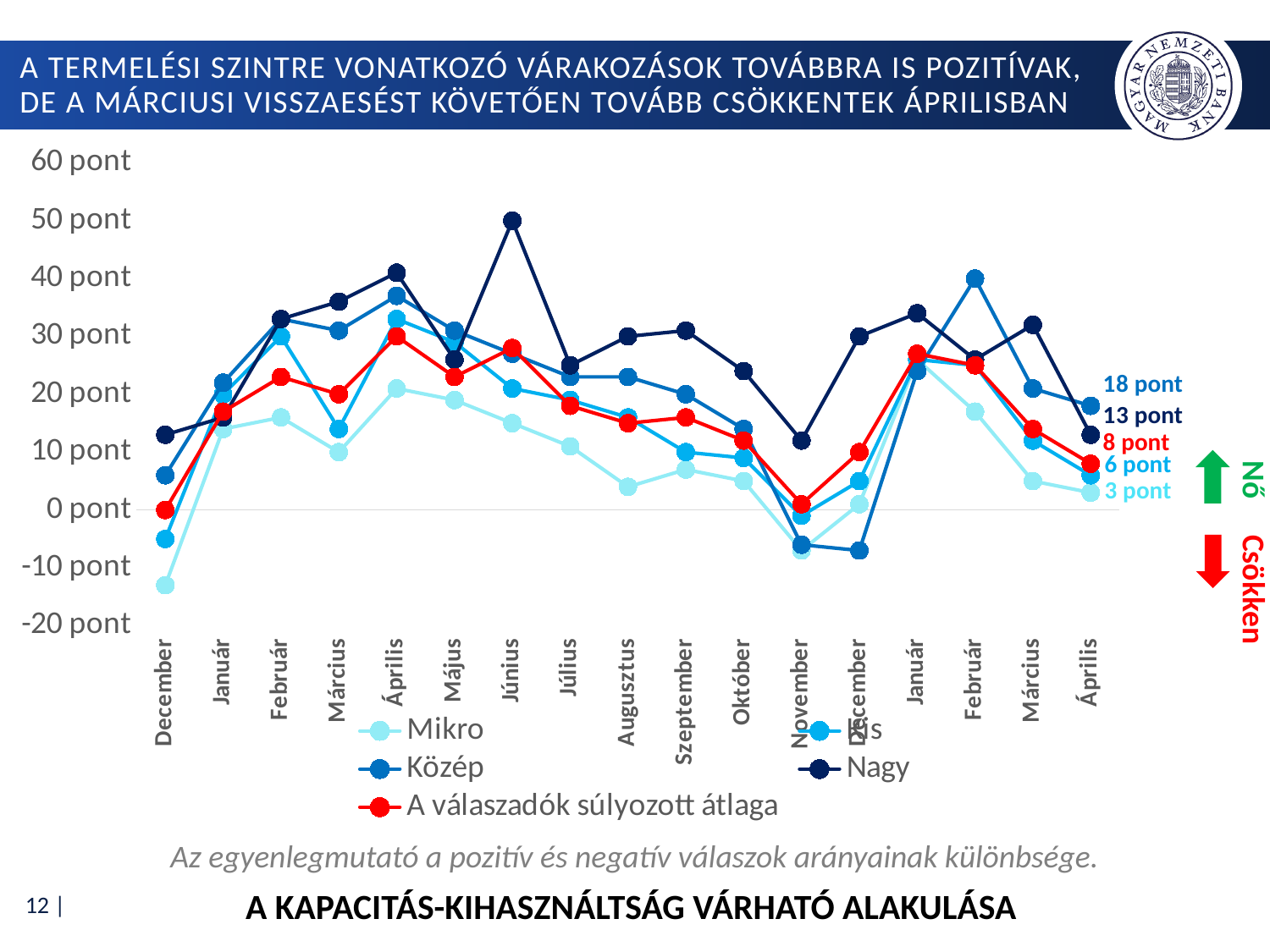
What is the value of the Nagy series at the final Április point? 13 pont What is the value of the Kis series at the final Április point? 6 pont What is the value of the Közép series at the final Április point? 18 pont At the final Április point, how much higher is the Közép series than the Nagy series? 5 pont Is the value of the Nagy series in Június greater or less than 40 pont? greater What kind of chart is shown on the slide? line chart How many series does the legend list? 5 Is the value of the Mikro series at the first December point greater or less than -10 pont? less How many months are shown along the x axis? 17 What is the value of the Mikro series at the final Április point? 3 pont What is the value of 'A válaszadók súlyozott átlaga' at the final Április point? 8 pont Which series has the highest value at the final Április point? Közép